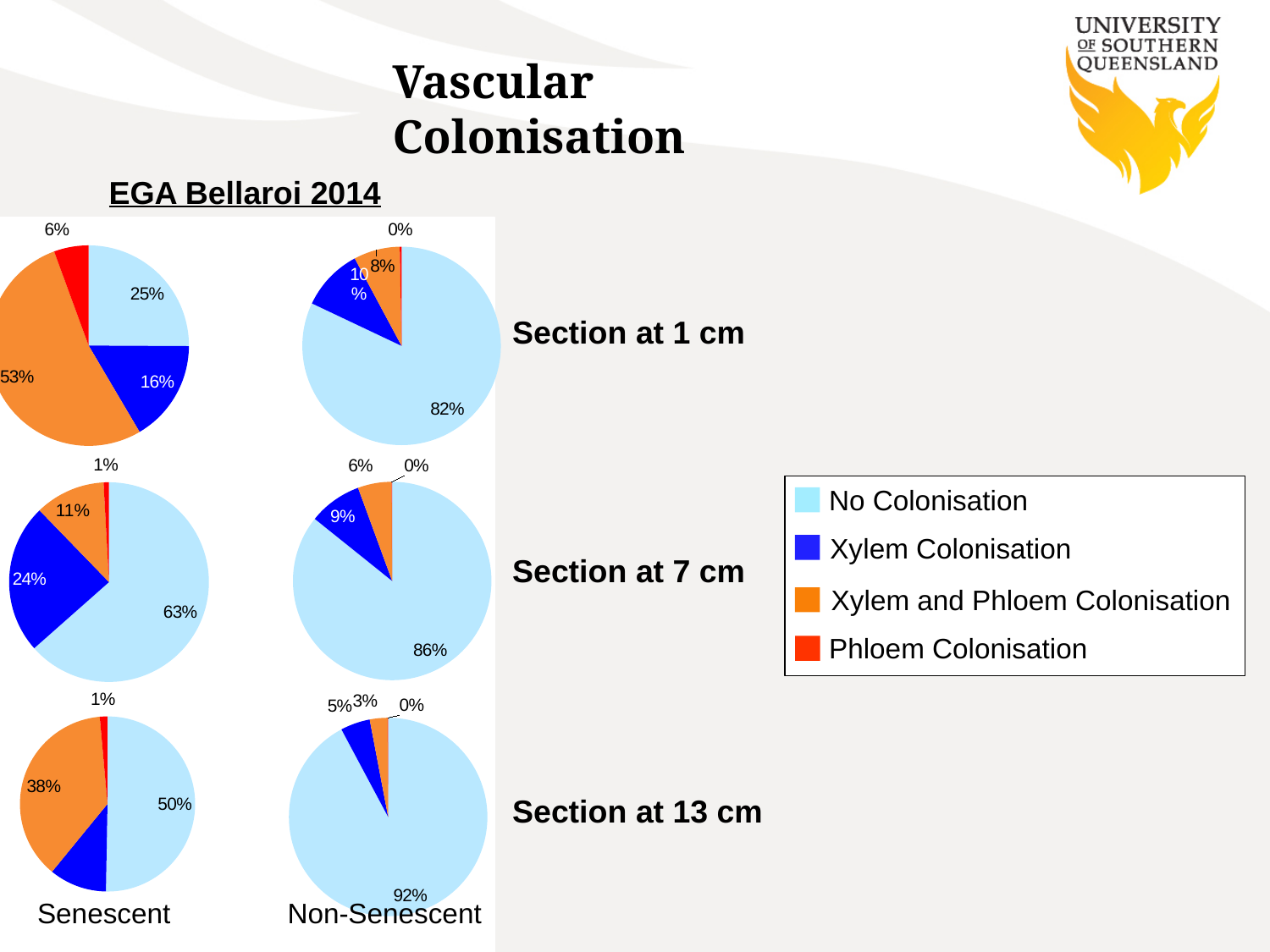
In the Non-Senescent pie chart for the section at 7 cm, what is the difference between the No Colonisation share and the Xylem Colonisation share? 77% What type of chart is used to show the vascular colonisation data? Pie chart In the Senescent pie chart for the section at 1 cm, what share is Xylem and Phloem Colonisation? 53% In the Senescent pie chart for the section at 7 cm, what share is Xylem Colonisation? 24% How many categories does the legend list? 4 In the Senescent pie chart for the section at 7 cm, which category has the smallest slice? Phloem Colonisation How many pie charts are shown on the slide? 6 In the Senescent pie chart for the section at 1 cm, which category has the largest slice? Xylem and Phloem Colonisation In the Non-Senescent pie chart for the section at 13 cm, what share is No Colonisation? 92% In the Senescent pie chart for the section at 13 cm, what share is Xylem and Phloem Colonisation? 38% Which is larger: the No Colonisation share in the Senescent pie chart at 7 cm or the No Colonisation share in the Non-Senescent pie chart at 7 cm? Non-Senescent In the Non-Senescent pie chart for the section at 1 cm, what share is No Colonisation? 82%